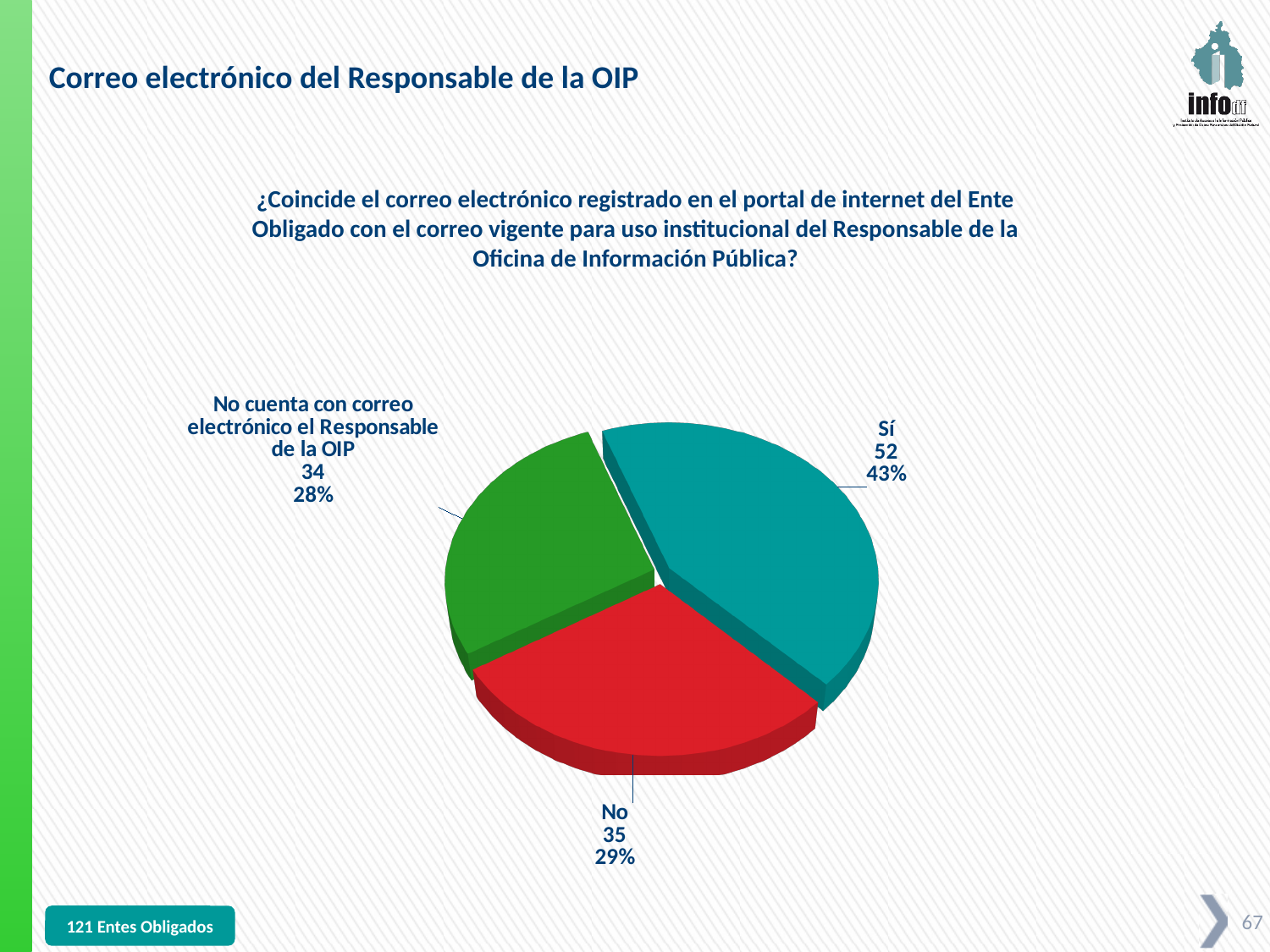
Which slice is the smallest? No cuenta con correo electrónico el Responsable de la OIP What is the total count across all three slices? 121 What is the count for the "Sí" slice? 52 Which has a larger count, "No" or "No cuenta con correo electrónico el Responsable de la OIP"? No What percentage share does the "Sí" slice represent? 43% How many slices does the pie chart have? 3 What is the count for "No cuenta con correo electrónico el Responsable de la OIP"? 34 Which slice is the largest? Sí What kind of chart is shown on the slide? Pie chart What percentage share does the "No" slice represent? 29% What colour is the "Sí" slice? Teal What is the difference in count between "Sí" and "No"? 17